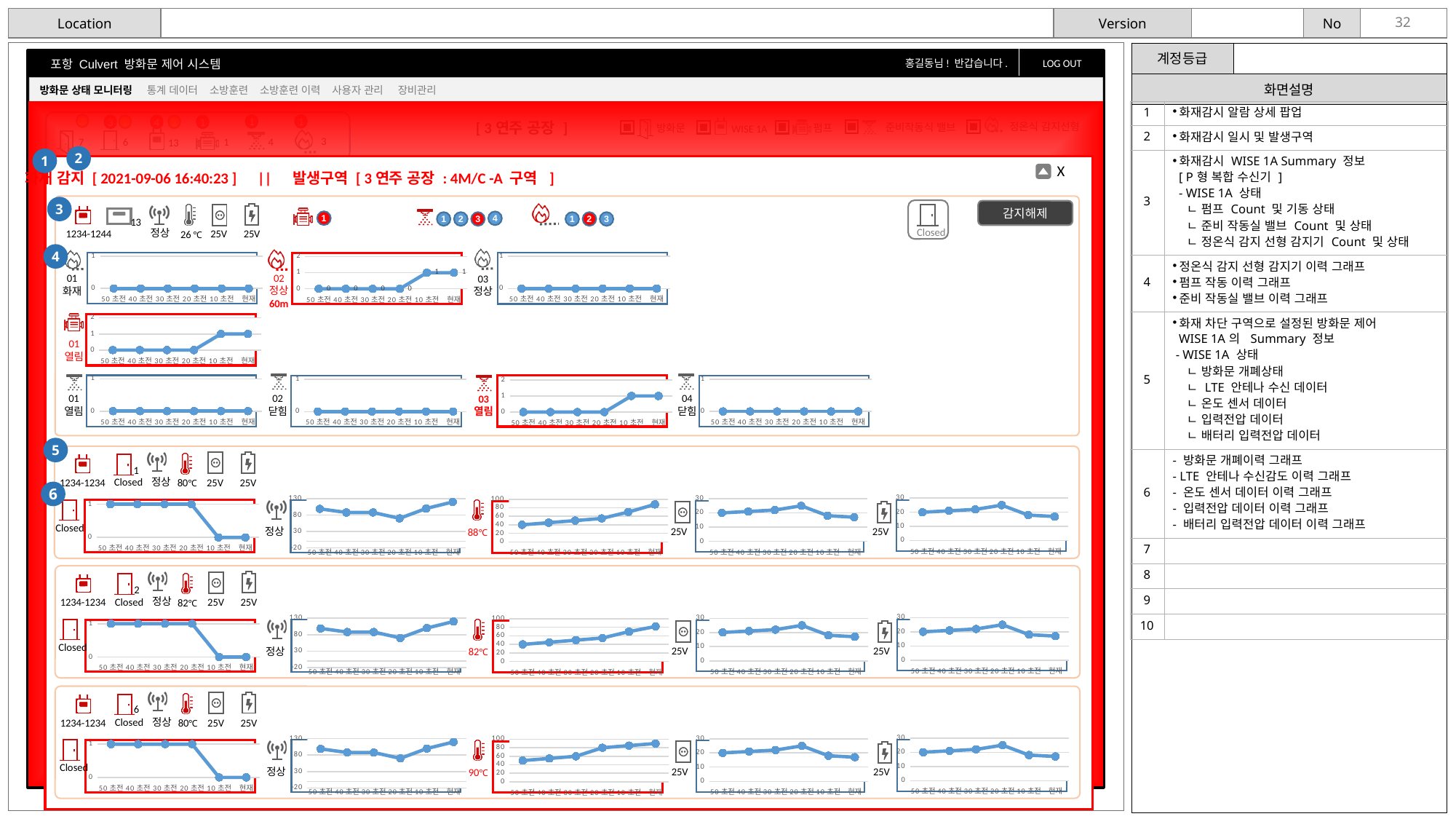
How many data points are plotted in the chart next to the label 02 정상 60m? 6 What is the label of the last point on the x axis of the history charts (e.g. the chart next to 02 정상 60m)? 현재 In the first door row (door 1, 80℃), is the 50 초전 value in the temperature chart next to 88℃ greater or less than 60? less What kind of chart is used for the history graphs on this slide (for example the chart next to the label 02 정상 60m)? line chart In the first door row (door 1, 80℃), does the line in the temperature chart next to 88℃ rise or fall from 50 초전 to 현재? rise In the chart next to the label 02 정상 60m, what value is printed for the 현재 (current) point? 1 In the first door row (door 1, 80℃), does the line in the chart next to the Closed icon rise or fall from 50 초전 to 현재? fall How many history charts are shown in each door row (the rows starting with 1234-1234)? 5 In the chart next to the label 02 정상 60m, do the values rise or fall from 50 초전 to 현재? rise In the first door row (door 1, 80℃), is the 현재 value in the chart next to the 정상 antenna icon greater or less than 80? greater In the chart next to the label 02 정상 60m, what value is printed for the 50 초전 point? 0 In the first door row (door 1, 80℃), is the 현재 value in the temperature chart next to 88℃ greater or less than 60? greater